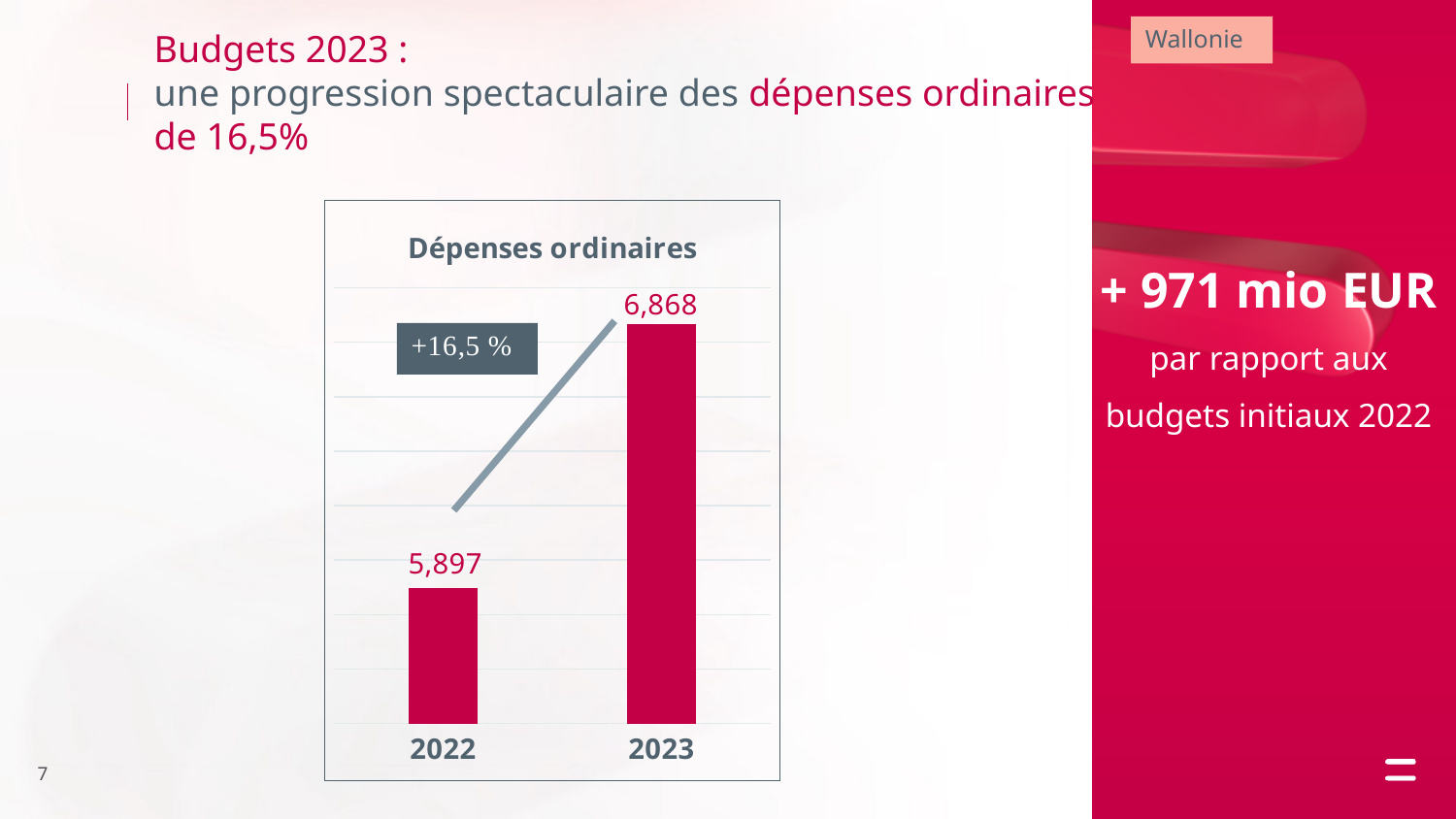
In the Dépenses ordinaires chart, is the value for 2023 larger or smaller than the value for 2022? larger Which year has the lowest value in the Dépenses ordinaires chart? 2022 What kind of chart is the Dépenses ordinaires chart? bar chart What is the difference between the 2023 and 2022 values in the Dépenses ordinaires chart? 971 What is the value of the bar for 2023 in the Dépenses ordinaires chart? 6,868 What is the value of the bar for 2022 in the Dépenses ordinaires chart? 5,897 What percentage change is annotated on the Dépenses ordinaires chart? +16,5 % Do the values in the Dépenses ordinaires chart rise or fall from 2022 to 2023? rise What is the title of the chart on the slide? Dépenses ordinaires How many bars are shown in the Dépenses ordinaires chart? 2 Which year has the highest value in the Dépenses ordinaires chart? 2023